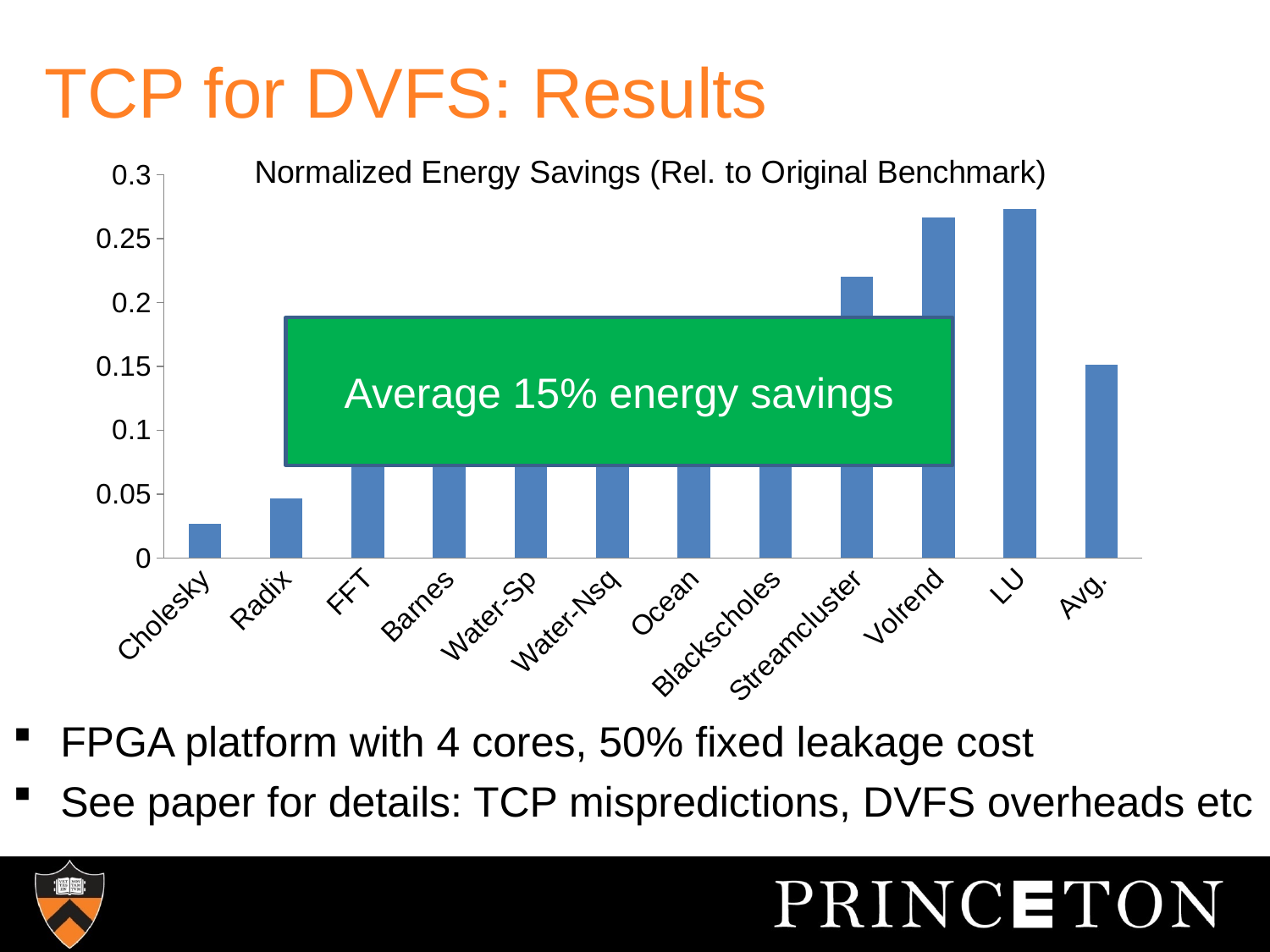
How many categories are shown along the x axis of the chart? 12 Is the value for Streamcluster greater or less than 0.2? greater Which is larger, the value for LU or the value for Avg.? LU What does the green box overlaid on the chart say? Average 15% energy savings Which is larger, the value for Streamcluster or the value for Cholesky? Streamcluster Is the value for Avg. greater or less than 0.1? greater Is the value for Cholesky greater or less than 0.05? less What kind of chart is shown on the slide? bar chart What is the title of the chart? Normalized Energy Savings (Rel. to Original Benchmark) Which category has the lowest normalized energy savings? Cholesky